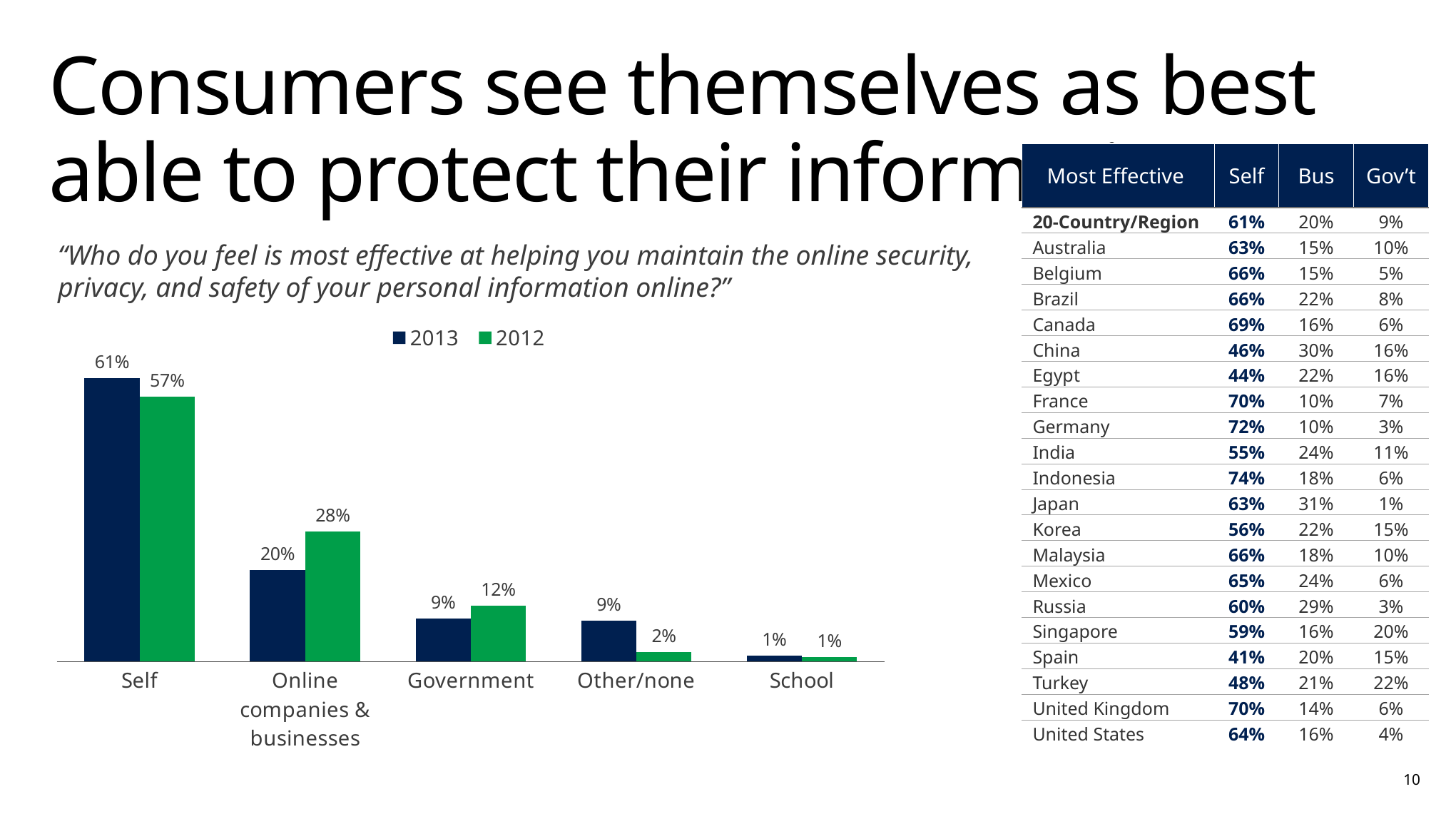
What kind of chart is shown on the slide? Bar chart What is the 2012 value for Other/none? 2% What is the 2012 value for Online companies & businesses? 28% Which category has the highest 2013 value? Self Which is larger for Government: the 2013 value or the 2012 value? 2012 What is the difference between the 2012 and 2013 values for Online companies & businesses? 8% What is the 2013 value for Government? 9% How many categories are shown on the x axis of the chart? 5 How many series does the chart legend list? 2 What is the difference between the 2013 and 2012 values for Self? 4% What is the 2013 value for Self? 61% Which category has the lowest 2012 value? School